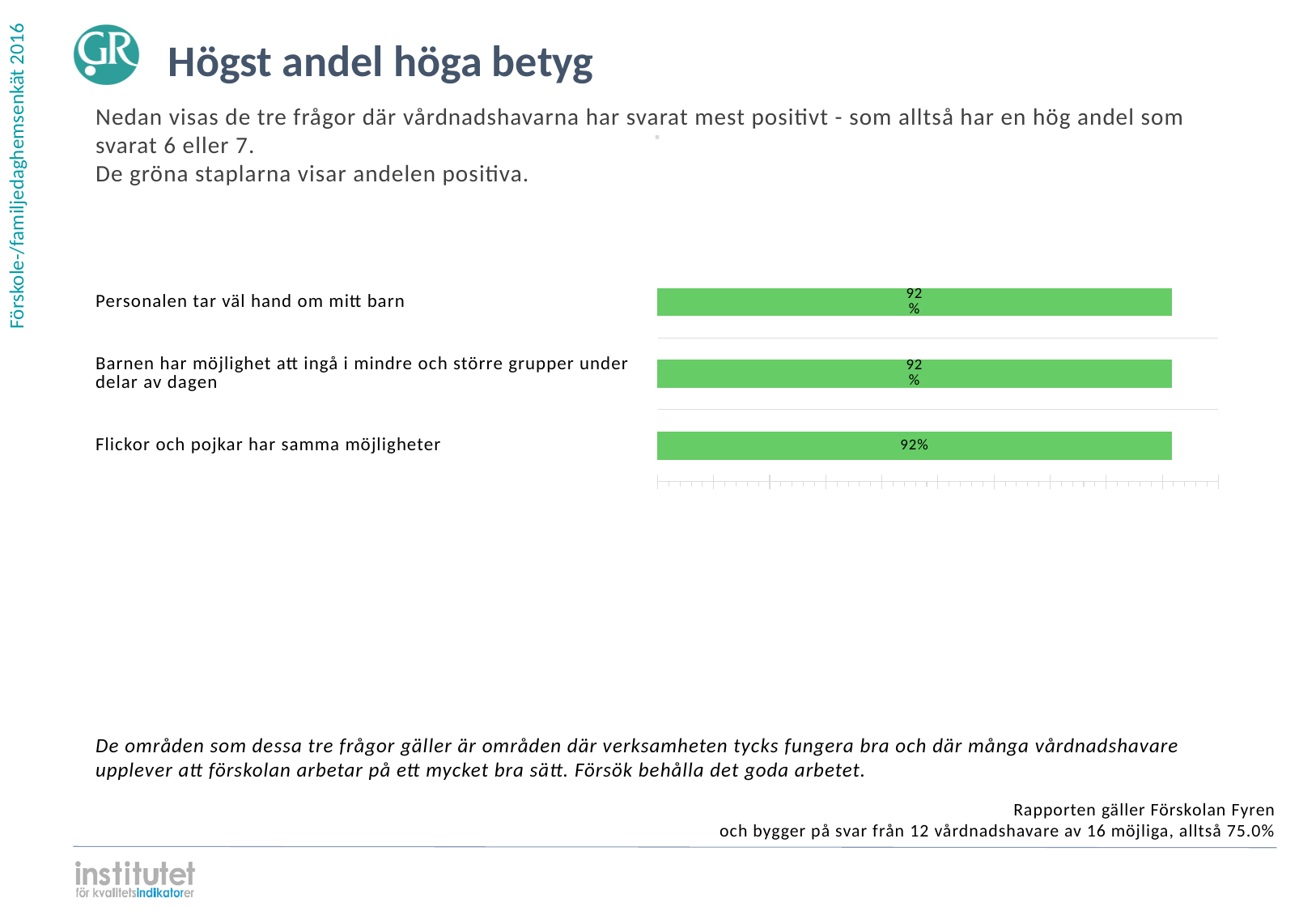
What colour are the bars in the chart? green What is the value for "Barnen har möjlighet att ingå i mindre och större grupper under delar av dagen"? 92% What is the difference between the value for "Personalen tar väl hand om mitt barn" and the value for "Flickor och pojkar har samma möjligheter"? 0% How many categories are shown in the chart? 3 What is the value for "Personalen tar väl hand om mitt barn"? 92% What kind of chart is shown on the slide? bar chart What is the value for "Flickor och pojkar har samma möjligheter"? 92% Do all three categories in the chart have the same value? yes What is the title of the slide containing the chart? Högst andel höga betyg